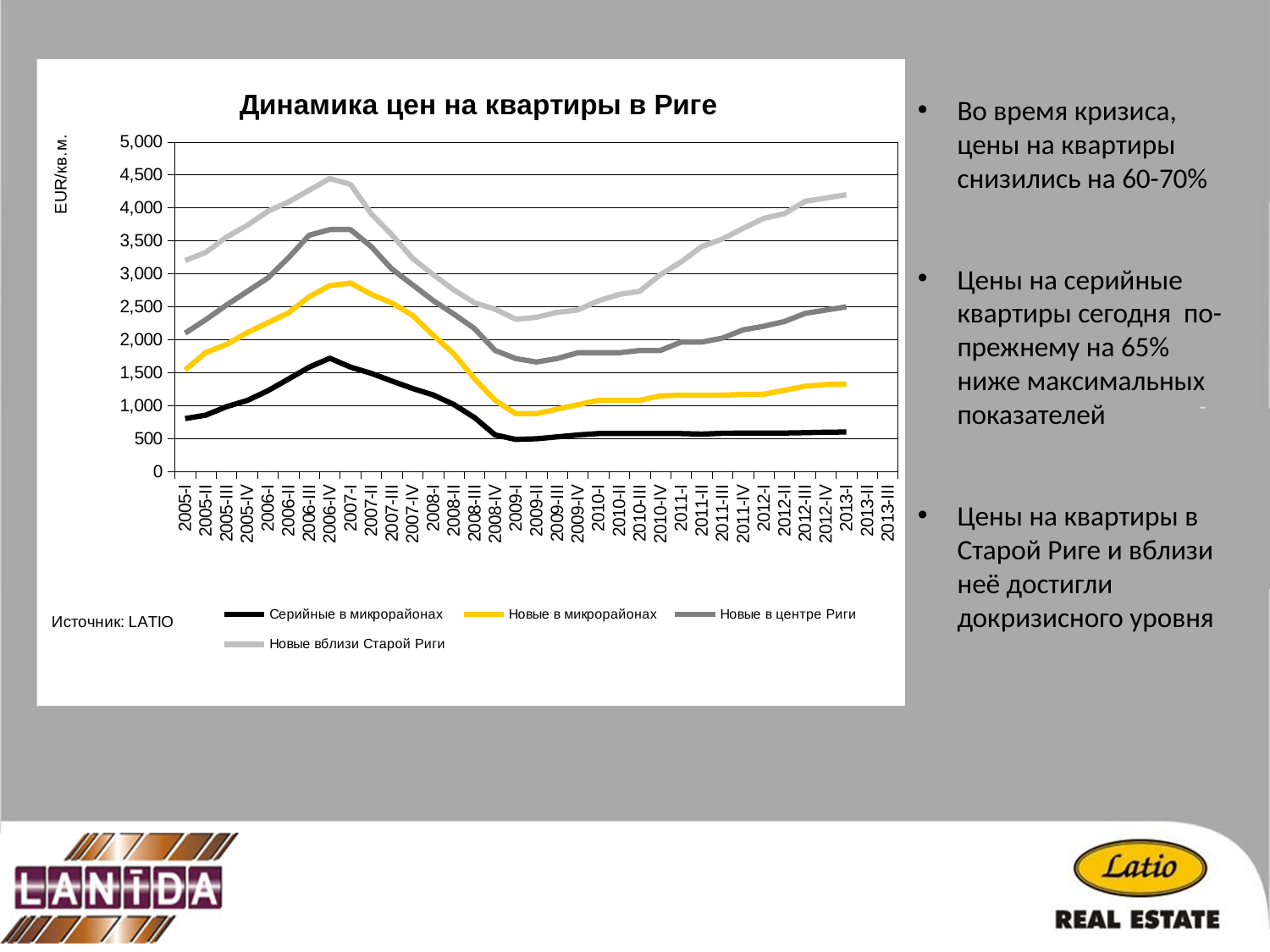
Is the value for Новые в микрорайонах at 2013-I greater or less than 1,000? greater How many series does the legend list? 4 How many quarters are labelled along the x axis of the chart? 35 Is the value for Новые вблизи Старой Риги at 2006-IV greater or less than 4,000? greater Which series has the highest value at 2006-IV? Новые вблизи Старой Риги Is the value for Серийные в микрорайонах at 2009-I greater or less than 1,000? less At 2013-I, which is larger: Новые вблизи Старой Риги or Новые в центре Риги? Новые вблизи Старой Риги What unit is shown on the vertical axis of the chart? EUR/кв.м. Does the Серийные в микрорайонах series rise or fall between 2006-IV and 2009-I? fall Which series has the lowest values across the whole period? Серийные в микрорайонах What is the title of the chart? Динамика цен на квартиры в Риге What kind of chart is shown on the slide? line chart